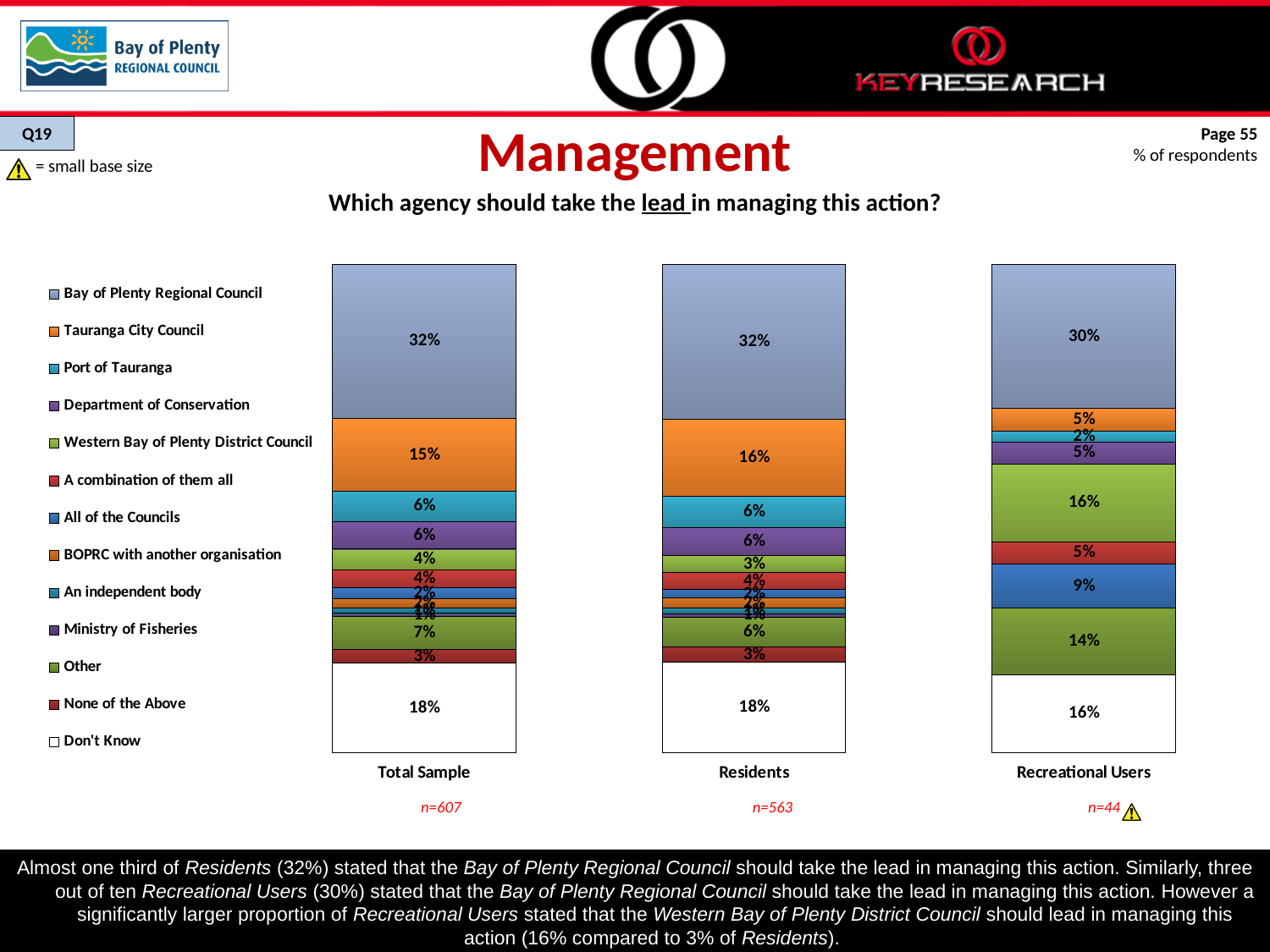
In the Residents chart, what percentage of respondents chose Tauranga City Council? 16% In the Recreational Users chart, what percentage of respondents chose Western Bay of Plenty District Council? 16% What is the difference between the Western Bay of Plenty District Council share for Recreational Users (16%) and for Residents (3%)? 13 percentage points How many entries does the legend list? 13 What kind of chart is used on this slide? Stacked bar chart In the Recreational Users chart, which agency has the largest share? Bay of Plenty Regional Council What is the sample size (n) shown for the Residents chart? n=563 In the Total Sample chart, what percentage of respondents answered Don't Know? 18% In the Total Sample chart, what percentage of respondents chose Bay of Plenty Regional Council? 32% Which of the three charts is flagged with a small base size warning? Recreational Users Which is larger: the Tauranga City Council share in the Total Sample chart or in the Recreational Users chart? Total Sample In the Recreational Users chart, what percentage of respondents answered Don't Know? 16%